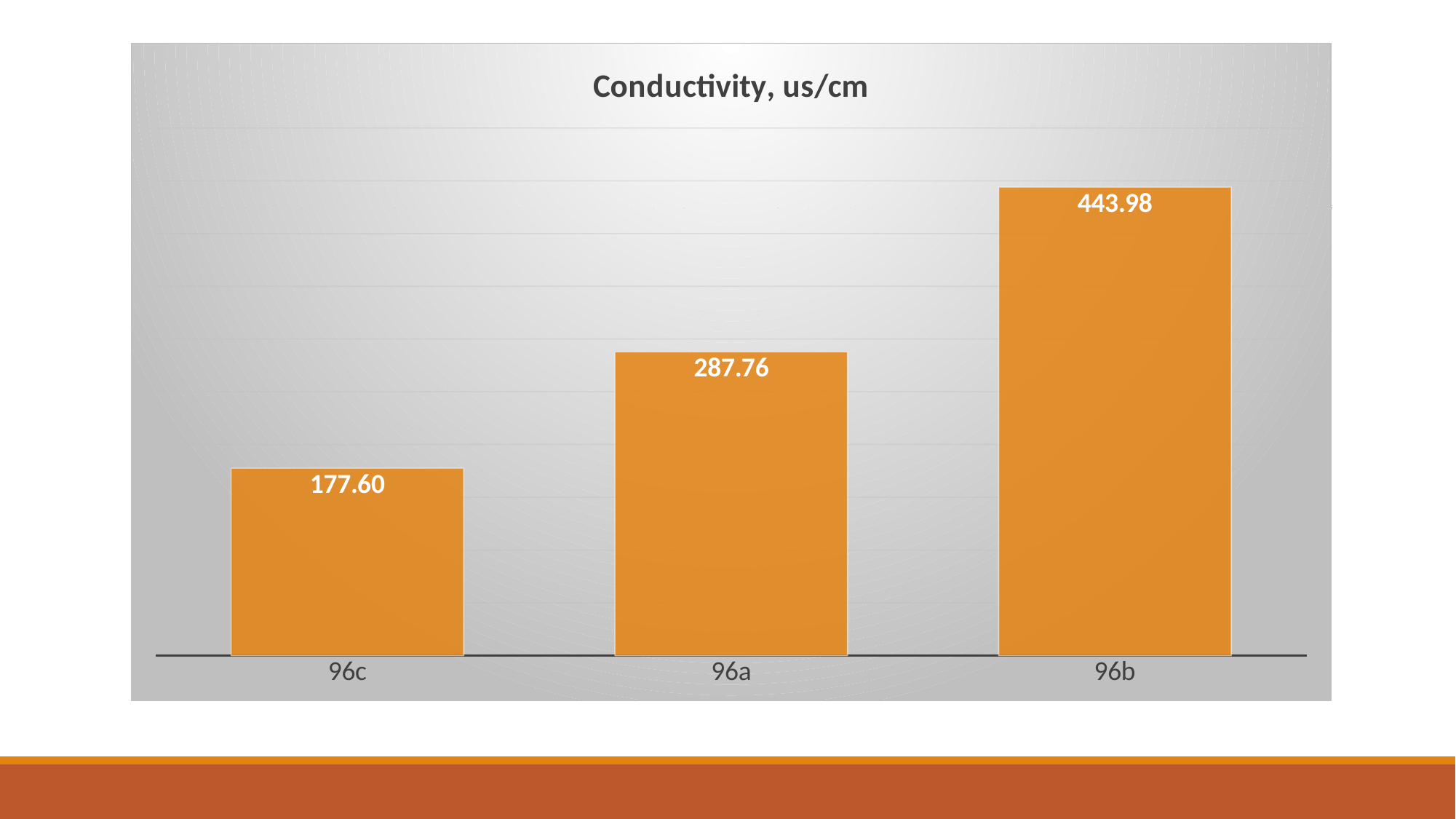
How many categories are shown in the chart? 3 What kind of chart is shown on the slide? Bar chart What is the difference in conductivity between 96b and 96a? 156.22 What is the title of the chart? Conductivity, us/cm Which has a higher conductivity, 96a or 96c? 96a Which category has the highest conductivity? 96b Which category has the lowest conductivity? 96c What is the difference in conductivity between 96a and 96c? 110.16 What is the conductivity value for 96c? 177.60 What is the conductivity value for 96a? 287.76 Do the values rise or fall from left to right along the x axis? Rise What is the conductivity value for 96b? 443.98